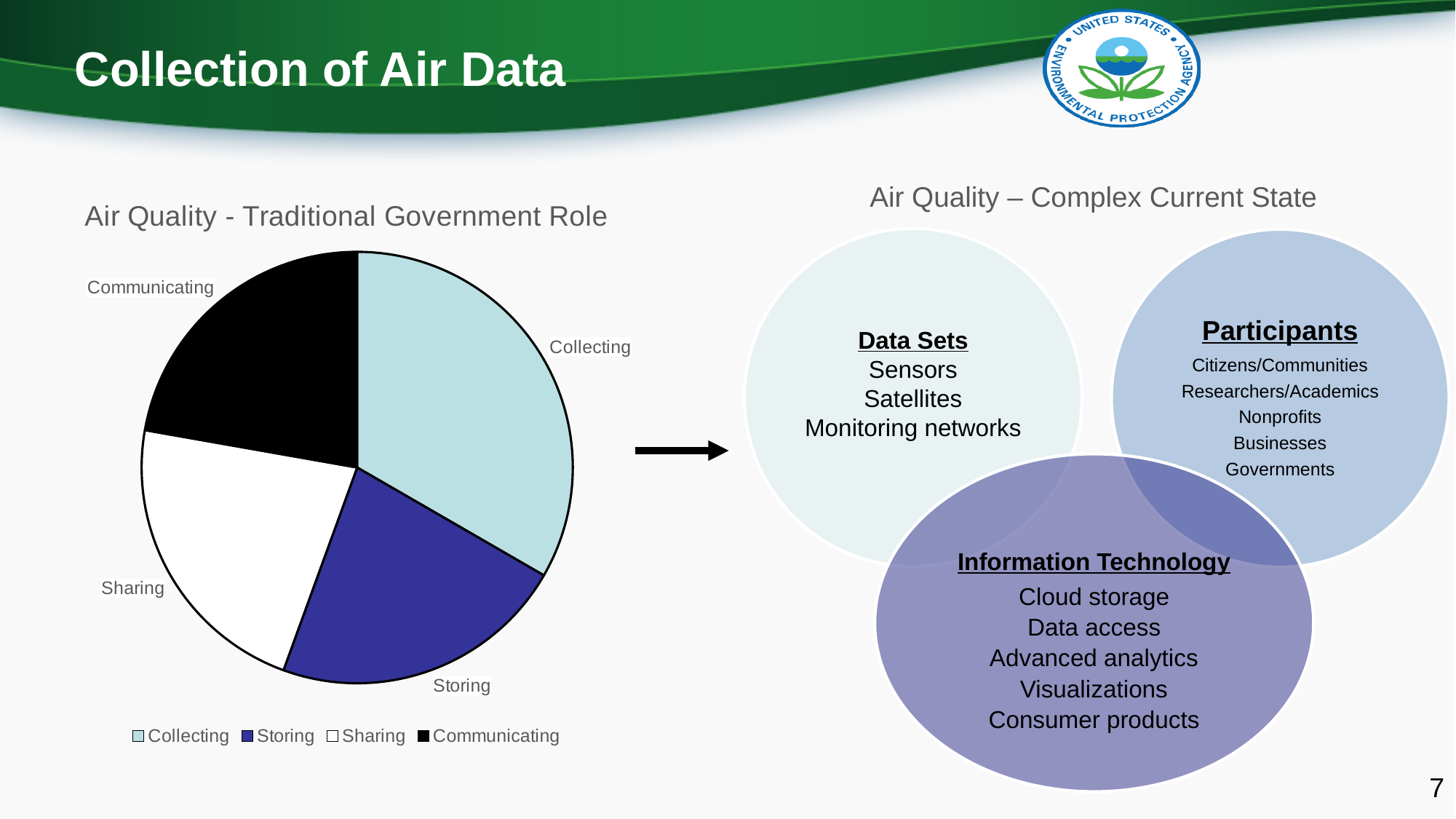
Which category is shown in black in the pie chart? Communicating Which category is shown in white in the pie chart? Sharing What kind of chart is shown on the slide? pie chart What is the title of the pie chart? Air Quality - Traditional Government Role How many entries does the pie chart's legend list? 4 Which category has the largest slice in the pie chart? Collecting Which slice is larger in the pie chart, Collecting or Communicating? Collecting Which slice is larger in the pie chart, Collecting or Storing? Collecting How many slices does the pie chart have? 4